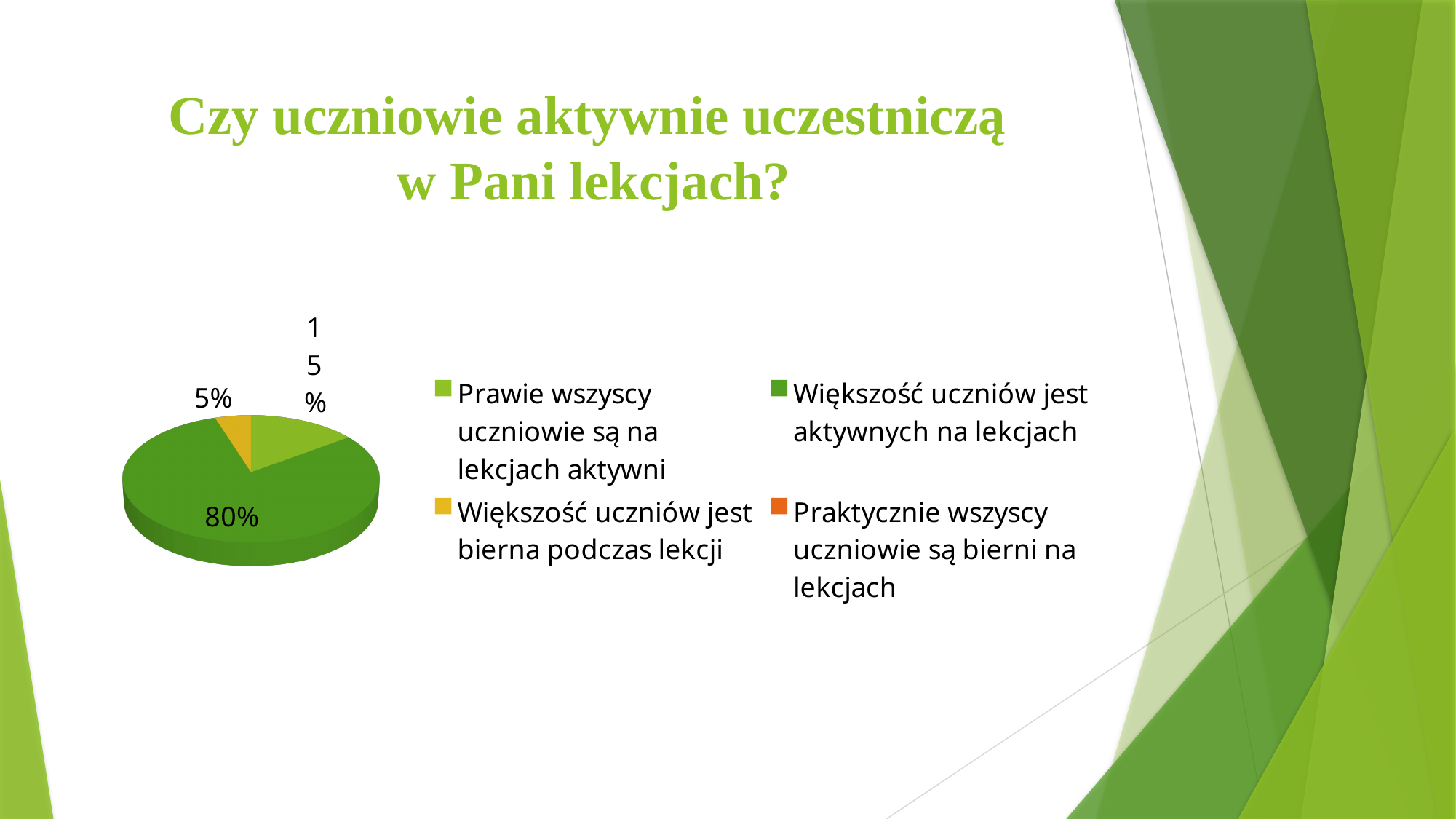
What kind of chart is shown on the slide? pie chart How many slices of the pie have a percentage label? 3 Which of the labelled slices has the smallest share of the pie? Większość uczniów jest bierna podczas lekcji Which answer has the largest share of the pie? Większość uczniów jest aktywnych na lekcjach What is the difference in percentage points between the "Prawie wszyscy uczniowie są na lekcjach aktywni" slice and the "Większość uczniów jest bierna podczas lekcji" slice? 10 What is the difference in percentage points between the 80% slice and the 15% slice? 65 What share of the pie corresponds to "Większość uczniów jest bierna podczas lekcji"? 5% What share of the pie corresponds to "Większość uczniów jest aktywnych na lekcjach"? 80% Which is larger: the share for "Prawie wszyscy uczniowie są na lekcjach aktywni" or the share for "Większość uczniów jest bierna podczas lekcji"? Prawie wszyscy uczniowie są na lekcjach aktywni What is the title of the slide containing the pie chart? Czy uczniowie aktywnie uczestniczą w Pani lekcjach? How many entries does the chart legend list? 4 What share of the pie corresponds to "Prawie wszyscy uczniowie są na lekcjach aktywni"? 15%